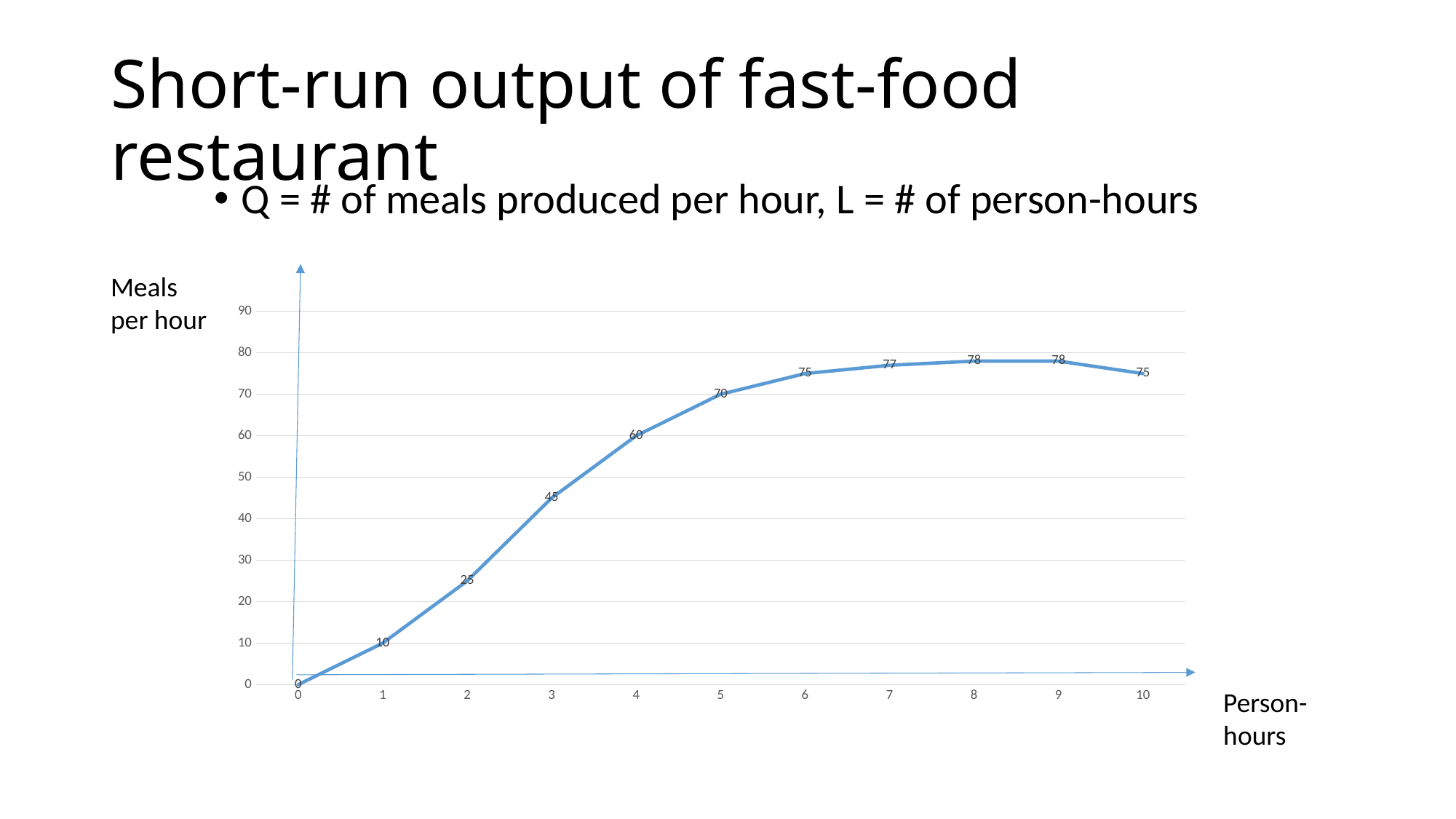
What is the highest value plotted on the line? 78 What is the value plotted at 5 person-hours? 70 How many data points are plotted on the line? 11 What type of chart is shown on the slide? line chart What label is shown on the vertical axis of the chart? Meals per hour What is the difference between the values at 4 and 2 person-hours? 35 What is the value plotted at 10 person-hours? 75 Which is larger, the value at 6 person-hours or the value at 10 person-hours? 6 person-hours What is the value plotted at 1 person-hour? 10 At which person-hours value is the lowest output plotted? 0 Does the line rise or fall between 0 and 8 person-hours? rise How many meals per hour are produced at 3 person-hours? 45